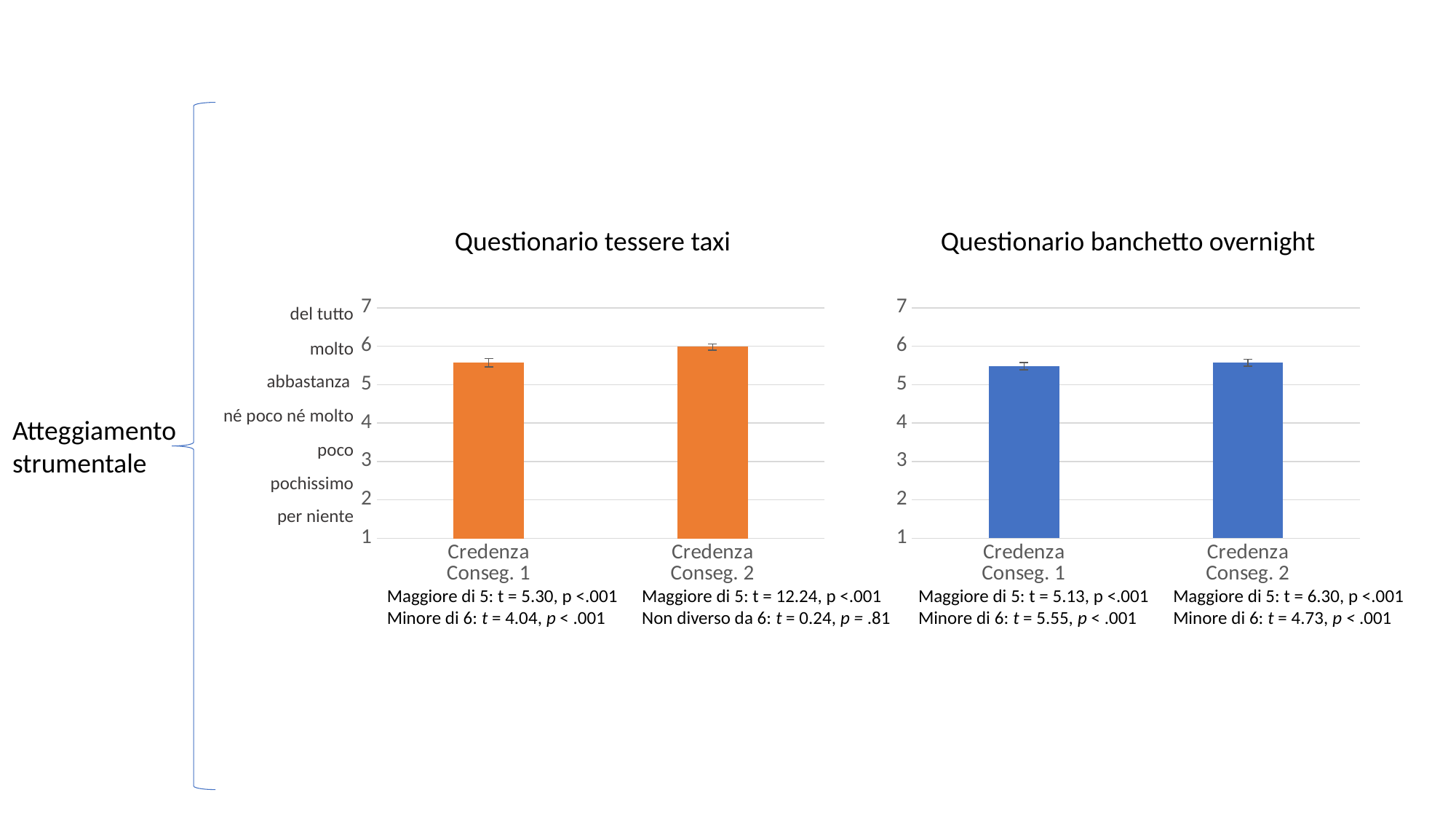
What is the title of the chart on the right side of the slide? Questionario banchetto overnight In the "Questionario tessere taxi" chart, is the value for Credenza Conseg. 1 greater or less than 5? greater How many bars does the "Questionario banchetto overnight" chart show? 2 In the "Questionario banchetto overnight" chart, is the value for Credenza Conseg. 2 greater or less than 6? less In the "Questionario tessere taxi" chart, which category has the highest value? Credenza Conseg. 2 In the "Questionario tessere taxi" chart, is the value for Credenza Conseg. 2 greater or less than 5? greater What colour are the bars in the "Questionario tessere taxi" chart? orange In the "Questionario tessere taxi" chart, which bar is higher, Credenza Conseg. 1 or Credenza Conseg. 2? Credenza Conseg. 2 What kind of chart is the "Questionario tessere taxi" chart? bar chart